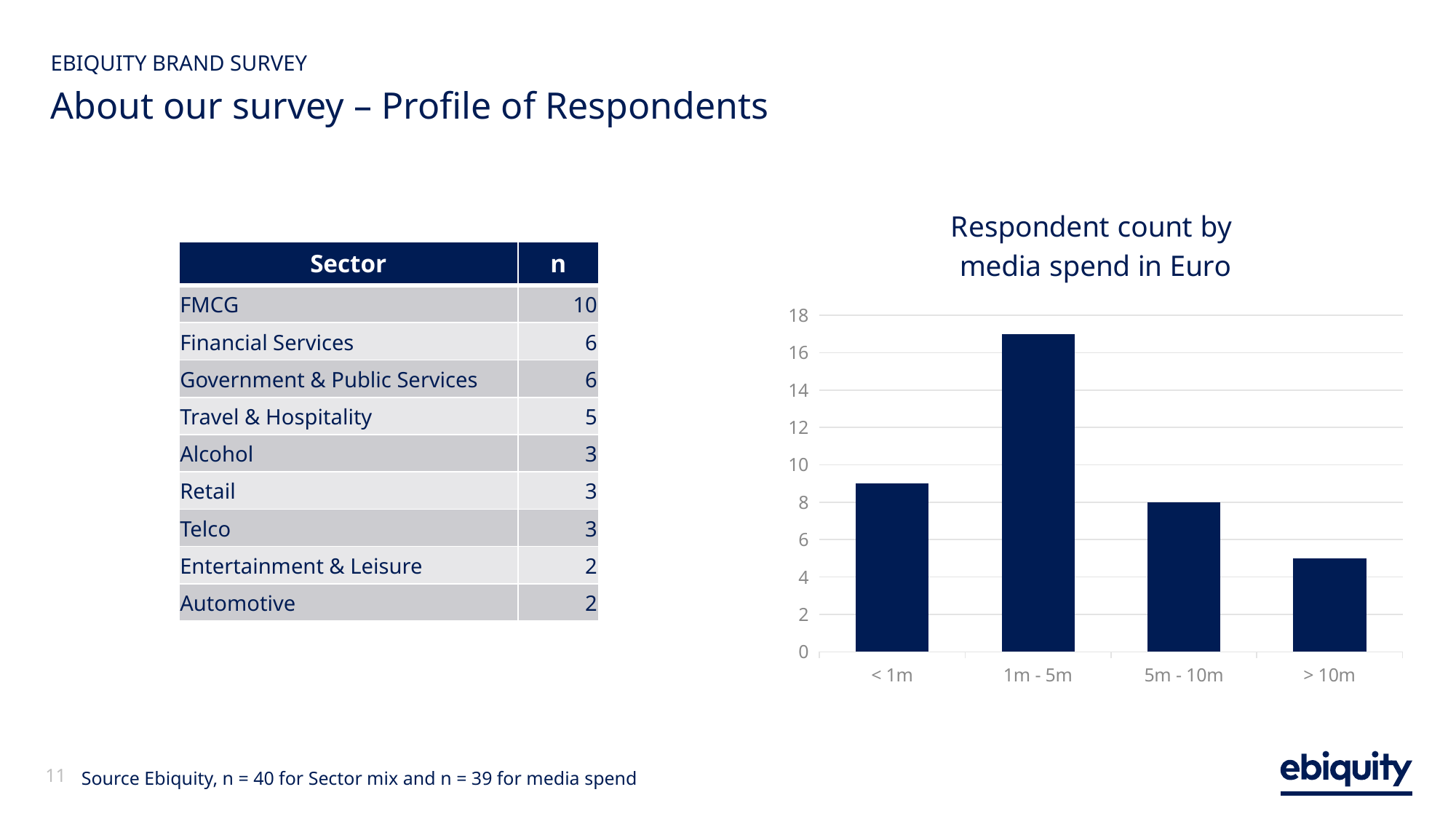
Is the respondent count for the > 10m category greater or less than 6? less Do the respondent counts rise or fall from the 1m - 5m category to the > 10m category? fall Which media spend category has the highest respondent count? 1m - 5m What is the respondent count for the 5m - 10m media spend category? 8 What is the title of the chart on the slide? Respondent count by media spend in Euro Is the respondent count for the 1m - 5m category greater or less than 16? greater What kind of chart is shown on the slide? bar chart Which has a larger respondent count, the < 1m category or the > 10m category? < 1m How many media spend categories are shown on the x axis of the chart? 4 Is the respondent count for the < 1m category greater or less than 10? less What is the highest value shown on the vertical axis of the chart? 18 Which media spend category has the lowest respondent count? > 10m